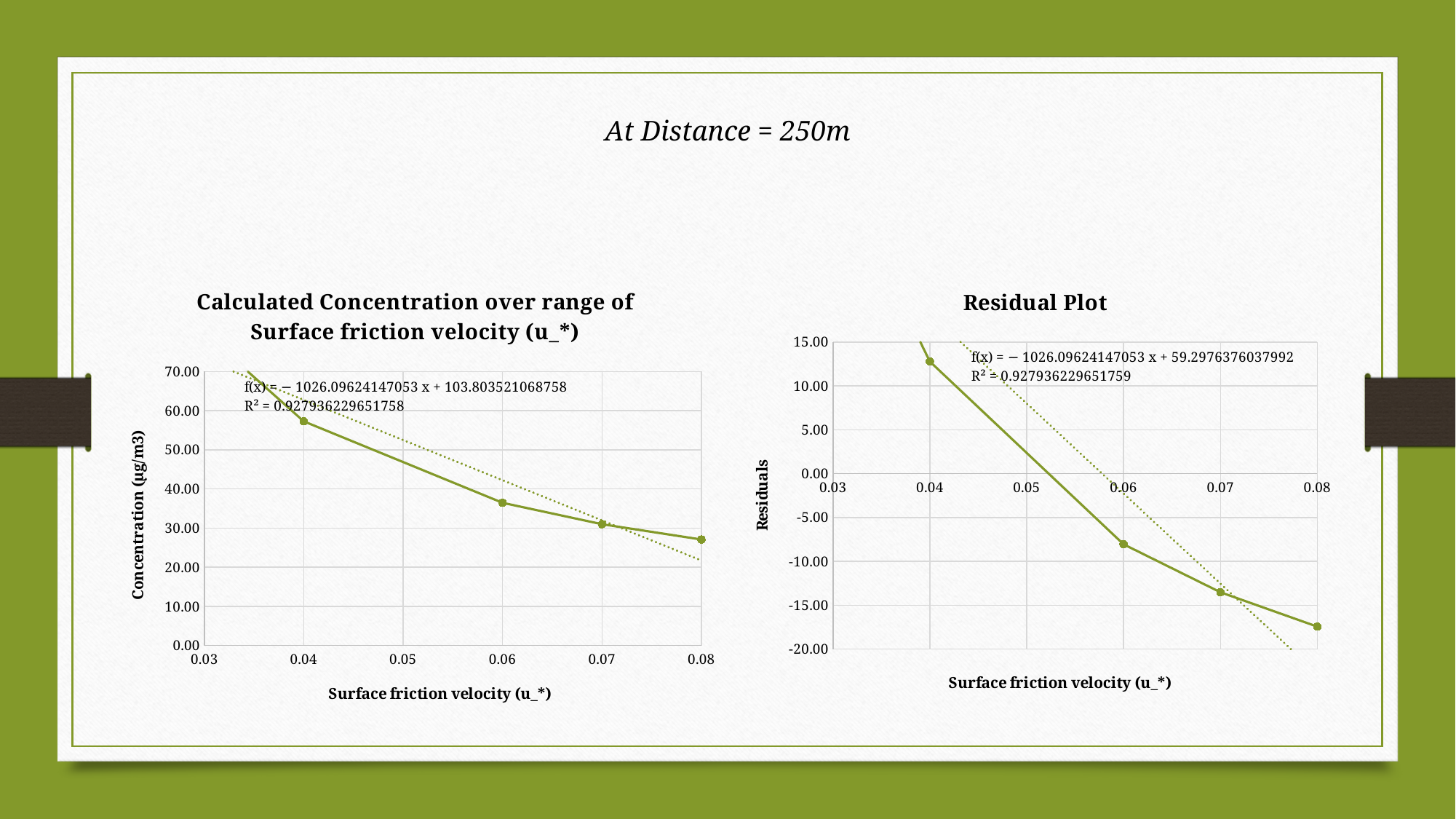
In the 'Residual Plot' chart, which is larger, the residual at 0.06 or the residual at 0.07? 0.06 In the 'Calculated Concentration over range of Surface friction velocity (u_*)' chart, what kind of chart is shown? line chart In the 'Calculated Concentration over range of Surface friction velocity (u_*)' chart, how many data points are plotted? 4 In the 'Calculated Concentration over range of Surface friction velocity (u_*)' chart, at which surface friction velocity is the concentration highest? 0.04 In the 'Calculated Concentration over range of Surface friction velocity (u_*)' chart, at which surface friction velocity is the concentration lowest? 0.08 In the 'Calculated Concentration over range of Surface friction velocity (u_*)' chart, what is the R² value shown for the trendline? 0.927936229651758 In the 'Calculated Concentration over range of Surface friction velocity (u_*)' chart, is the concentration at 0.04 greater or less than 50.00? greater In the 'Calculated Concentration over range of Surface friction velocity (u_*)' chart, is the concentration at 0.08 greater or less than 30.00? less In the 'Calculated Concentration over range of Surface friction velocity (u_*)' chart, do the concentration values rise or fall as surface friction velocity increases? fall In the 'Residual Plot' chart, is the residual at 0.04 greater or less than 10.00? greater In the 'Residual Plot' chart, how many data points are plotted? 4